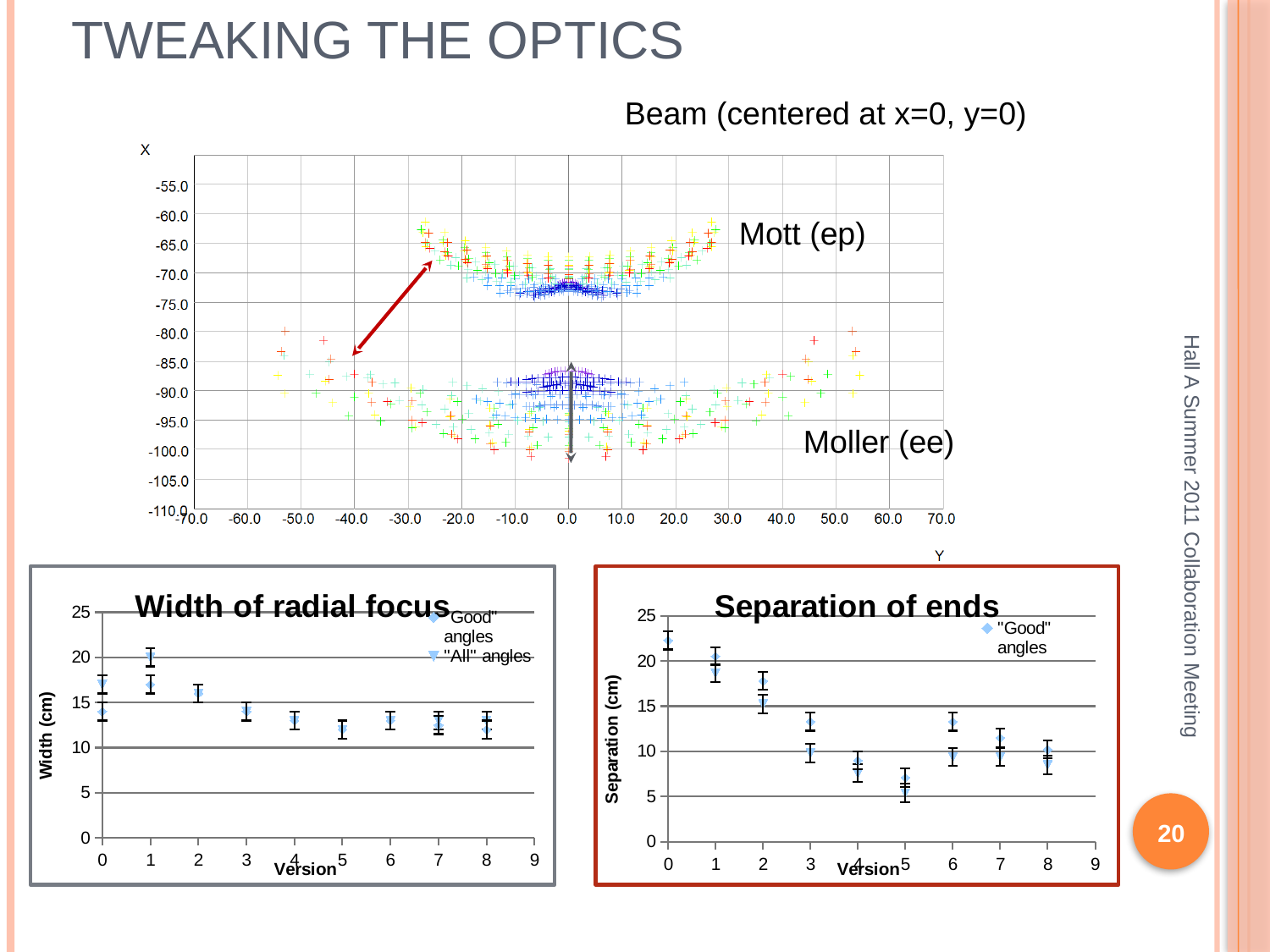
In the "Separation of ends" chart, is the value for version 0 greater or less than 20? greater What is the y-axis title of the "Separation of ends" chart? Separation (cm) In the "Width of radial focus" chart, is the "Good" angles value for version 8 greater or less than 15? less In the "Separation of ends" chart, which version has the highest separation? Version 0 How many series does the legend of the "Width of radial focus" chart list? 2 In the "Separation of ends" chart, is the value for version 5 greater or less than 10? less How many series does the legend of the "Separation of ends" chart list? 1 In the "Width of radial focus" chart, do the width values generally rise or fall as the version number increases? fall In the "Separation of ends" chart, how many versions have a plotted point? 9 What kind of chart is the "Width of radial focus" chart? scatter chart In the "Separation of ends" chart, which is larger: the value for version 0 or the value for version 8? Version 0 In the "Separation of ends" chart, which version has the lowest separation? Version 5